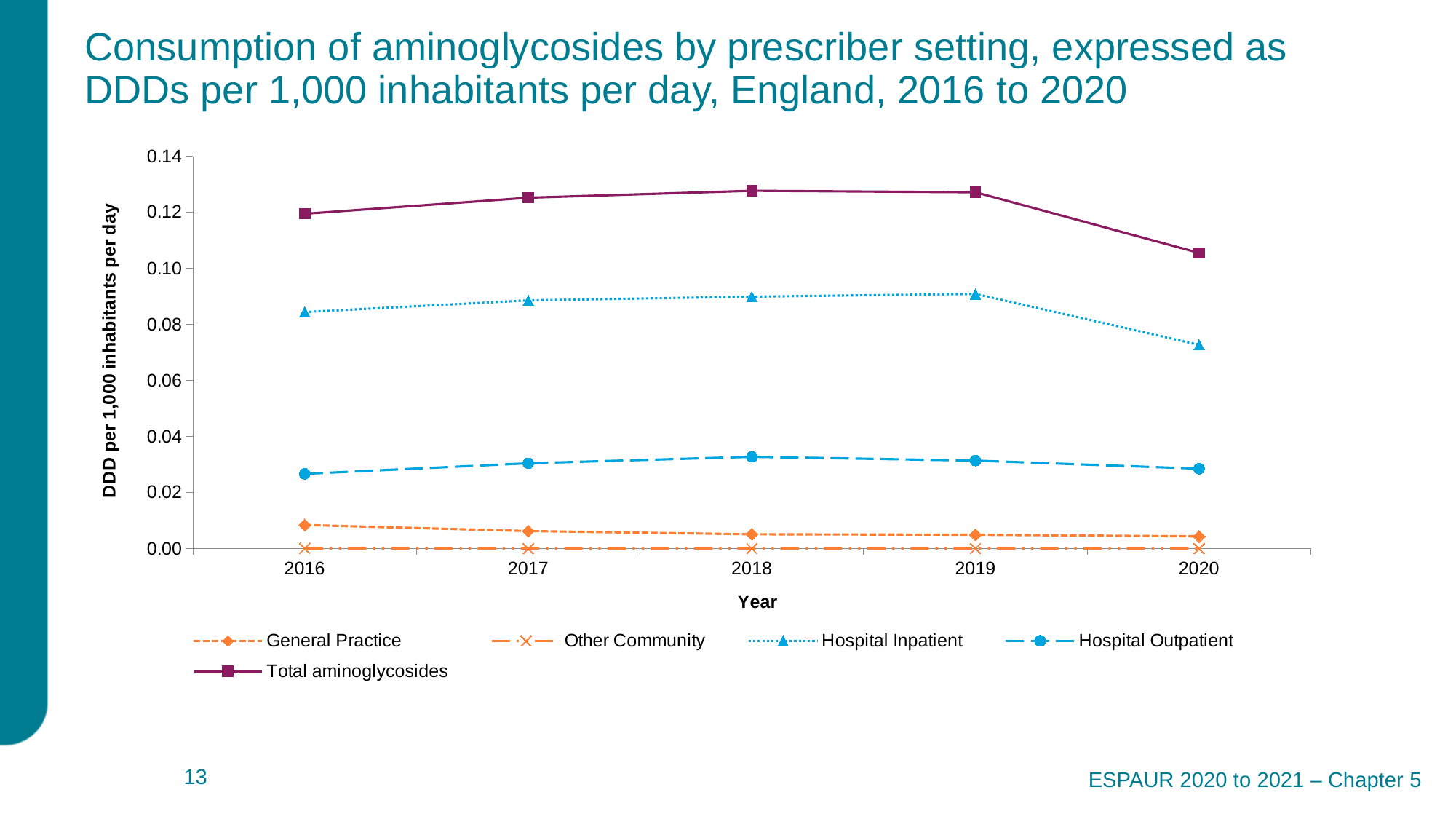
In which year is the Total aminoglycosides value lowest? 2020 Is the Hospital Outpatient value for 2018 greater or less than 0.04? less Which series has the lowest values across all years? Other Community Is the Total aminoglycosides value for 2020 greater or less than 0.10? greater How many series does the legend list? 5 In 2018, which is larger: Hospital Inpatient or Hospital Outpatient? Hospital Inpatient In which year is the Hospital Inpatient value lowest? 2020 Is the Hospital Inpatient value for 2020 greater or less than 0.08? less What is the title of the x axis? Year How many years are plotted along the x axis? 5 Does the Total aminoglycosides value rise or fall from 2019 to 2020? fall What kind of chart is shown on the slide? line chart